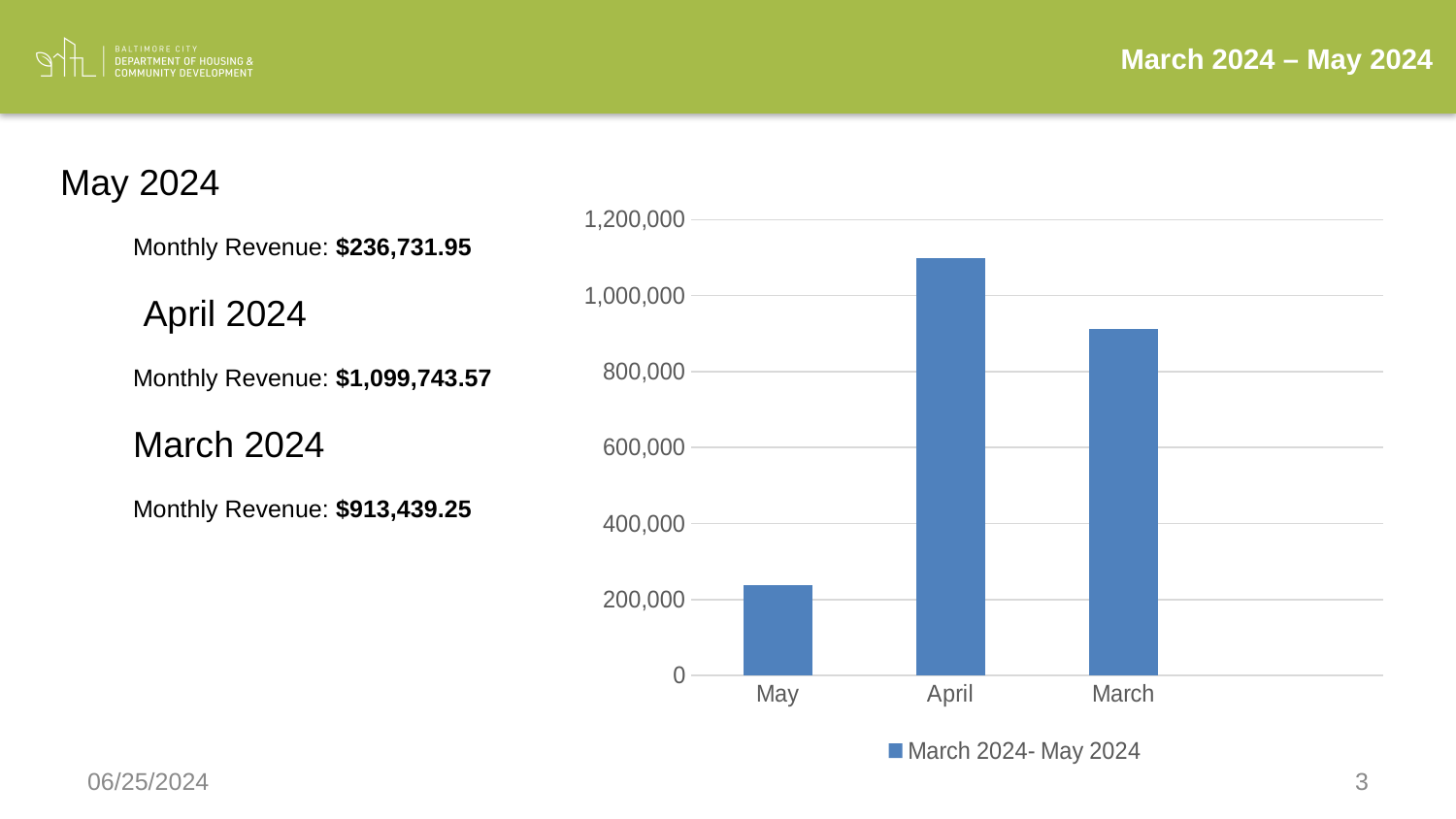
How many series does the chart legend list? 1 Which bar is taller, March or May? March What is the legend entry for the series in the chart? March 2024- May 2024 How many bars (categories) does the chart show? 3 Is the bar for April greater or less than 1,000,000? greater Which month has the lowest bar in the chart? May According to the slide text, what is the monthly revenue for May 2024? $236,731.95 What kind of chart is shown on the slide? bar chart Is the bar for May greater or less than 400,000? less Which month has the highest bar in the chart? April According to the slide text, what is the monthly revenue for April 2024? $1,099,743.57 Is the bar for March greater or less than 800,000? greater